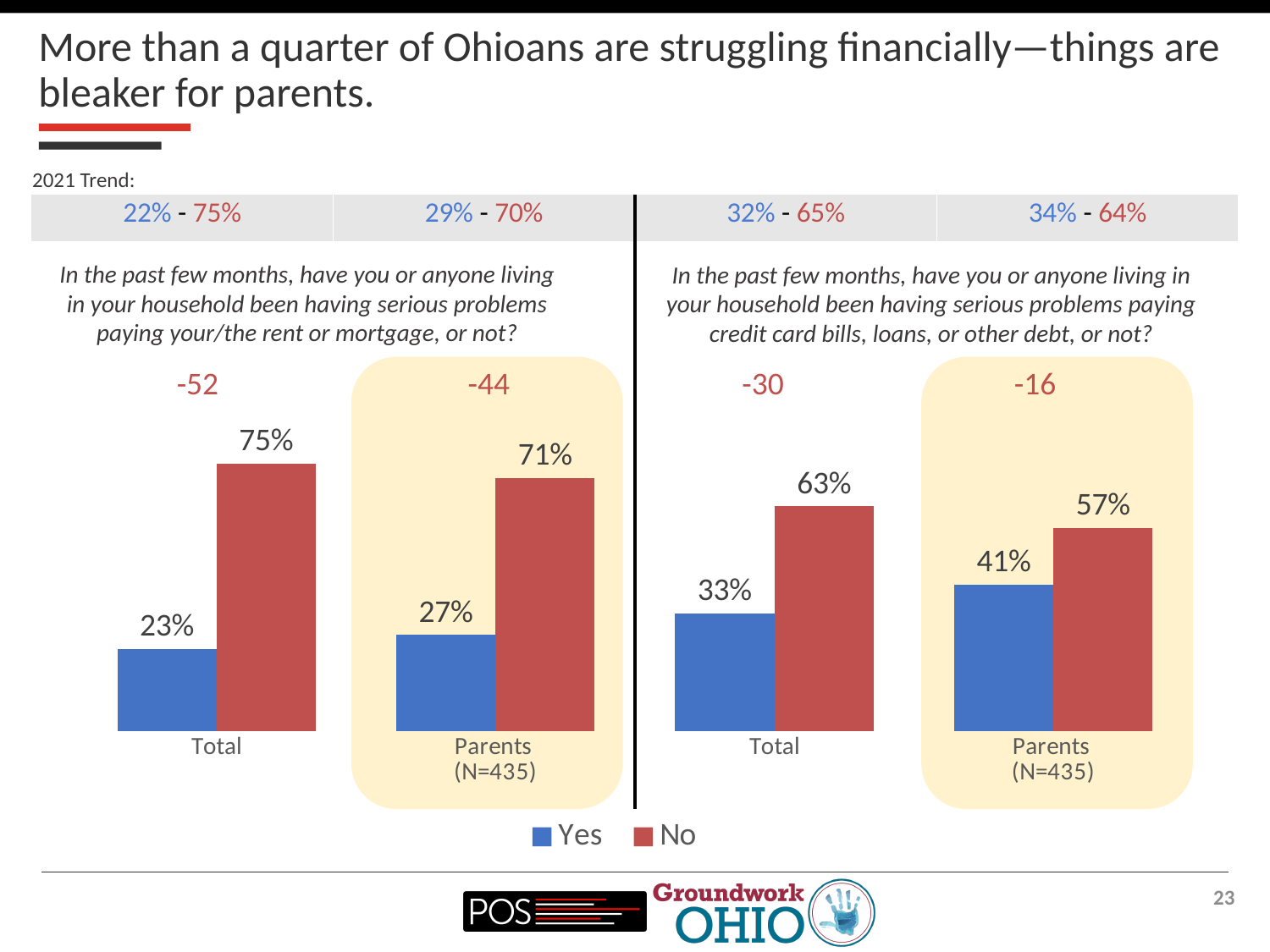
In the left chart about paying rent or mortgage, which group has the higher Yes percentage, Total or Parents (N=435)? Parents (N=435) In the right chart about paying credit card bills, loans, or other debt, what is the difference between the No and Yes percentages for Parents (N=435)? 16 In the right chart about paying credit card bills, loans, or other debt, what percentage of Parents (N=435) answered No? 57% How many series does the shared legend at the bottom of the slide list? 2 According to the legend, which colour represents the No responses? Red In the left chart about paying rent or mortgage, what percentage of Parents (N=435) answered No? 71% In the left chart about paying rent or mortgage, what is the difference between the No and Yes percentages for the Total group? 52 In the left chart about paying rent or mortgage, what percentage of the Total group answered Yes? 23% In the right chart about paying credit card bills, loans, or other debt, what percentage of the Total group answered Yes? 33% How many categories are shown on the x axis of the right chart about paying credit card bills, loans, or other debt? 2 What type of chart is used on the left side of the slide for the rent or mortgage question? Bar chart In the right chart about paying credit card bills, loans, or other debt, which group has the lower No percentage, Total or Parents (N=435)? Parents (N=435)